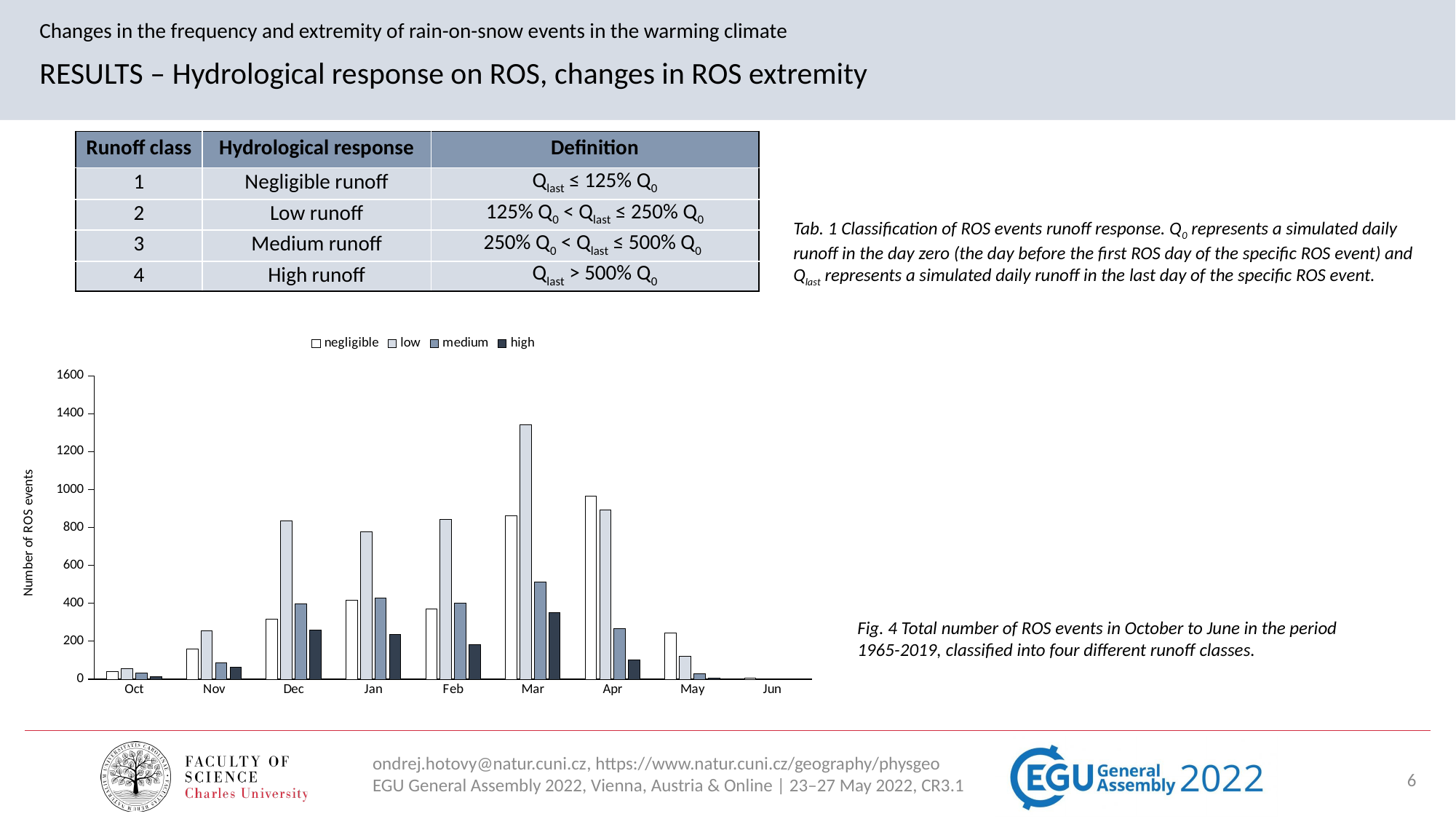
How many series does the chart legend list? 4 Is the value for 'low' in Mar greater or less than 1200? greater Is the value for 'negligible' in Apr greater or less than 800? greater Is the value for 'high' in Dec greater or less than 400? less Which series is shown with the darkest bars in the chart? high What is the label of the vertical axis of the chart? Number of ROS events What kind of chart is shown on the slide? bar chart How many months are shown along the x axis of the chart? 9 Which is larger in Mar: the 'medium' bar or the 'high' bar? medium In which month does the 'low' series reach its highest value? Mar In which month does the 'negligible' series reach its highest value? Apr Which is larger in Apr: the 'negligible' bar or the 'low' bar? negligible